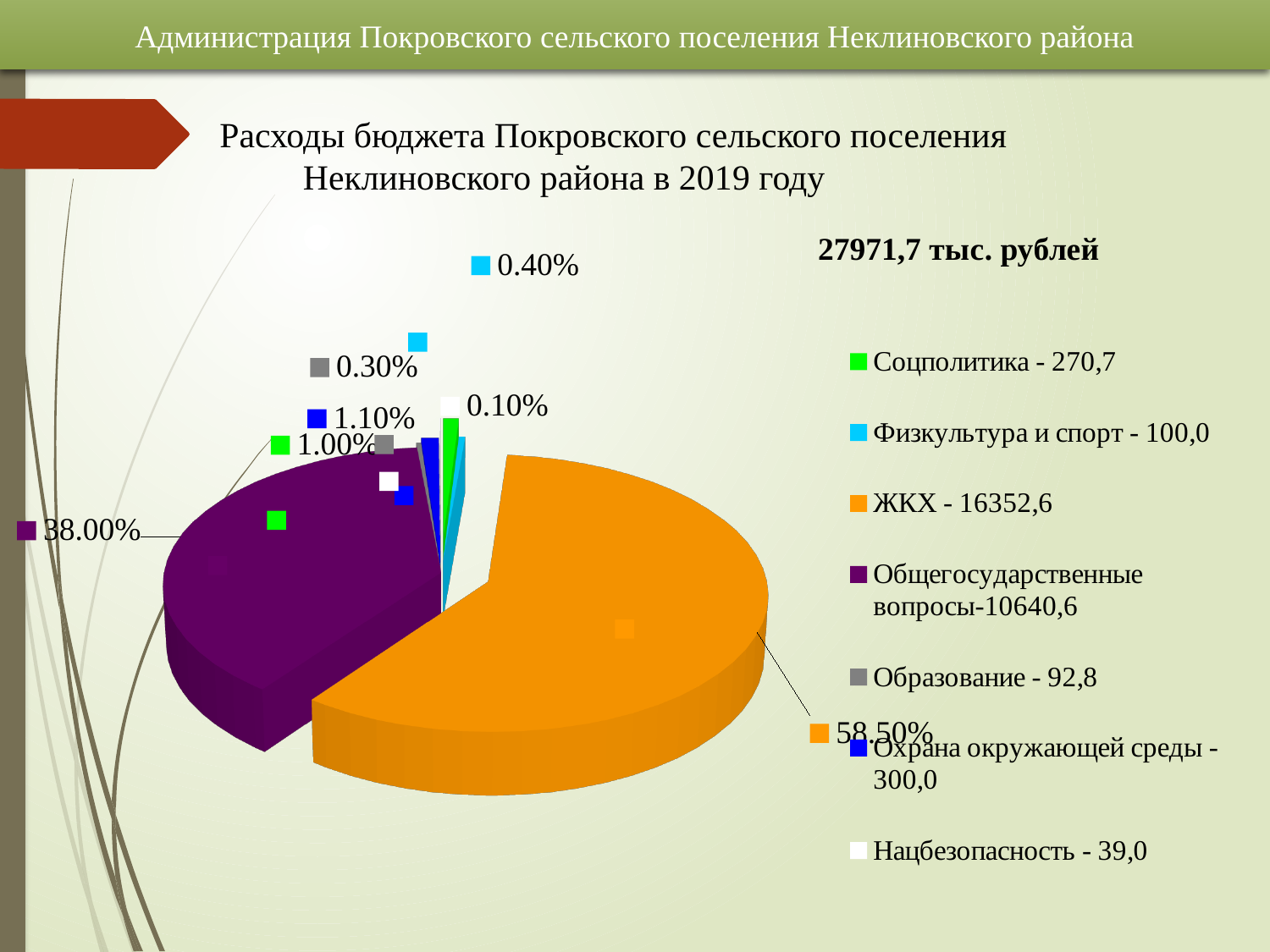
Which category has the largest slice of the pie? ЖКХ What total amount of budget expenditure is stated next to the chart? 27971,7 тыс. рублей What amount is listed in the legend for Охрана окружающей среды? 300,0 What percentage share is shown for the Физкультура и спорт slice? 0.40% What kind of chart is shown on the slide? pie chart What percentage share is shown for the ЖКХ slice? 58.50% What percentage share is shown for the Общегосударственные вопросы slice? 38.00% Which is larger, the share for Соцполитика or the share for Охрана окружающей среды? Охрана окружающей среды How many categories does the legend of the pie chart list? 7 What amount is listed in the legend for Образование? 92,8 Which category has the smallest slice of the pie? Нацбезопасность